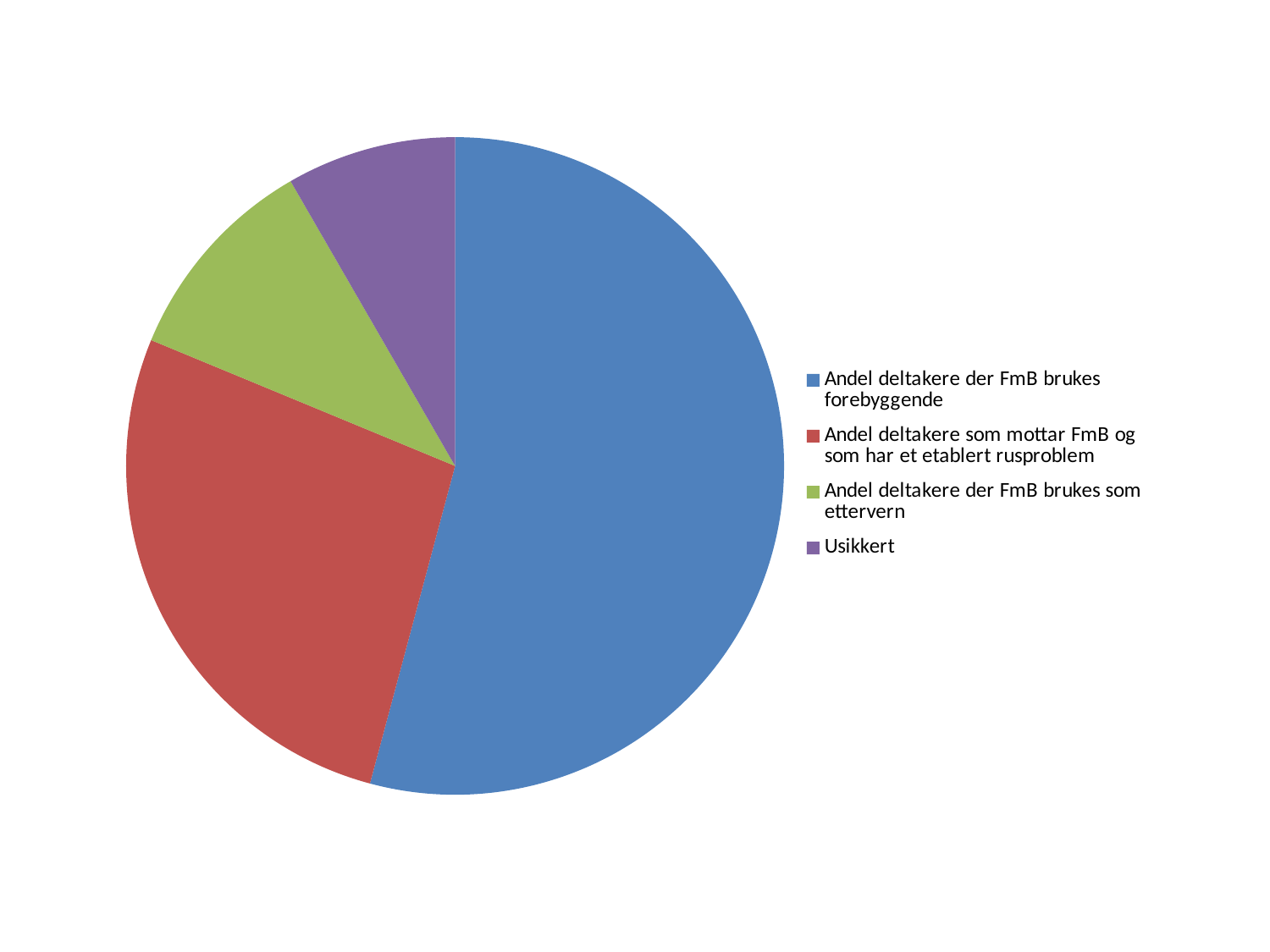
Which category has the largest slice of the pie? Andel deltakere der FmB brukes forebyggende Which slice is larger: "Andel deltakere der FmB brukes forebyggende" or "Usikkert"? Andel deltakere der FmB brukes forebyggende Which colour represents the "Usikkert" category in the pie chart? purple How many entries does the legend list? 4 How many slices does the pie chart have? 4 What kind of chart is shown on the slide? pie chart Which slice is larger: "Andel deltakere som mottar FmB og som har et etablert rusproblem" or "Andel deltakere der FmB brukes som ettervern"? Andel deltakere som mottar FmB og som har et etablert rusproblem Which category is shown in green in the pie chart? Andel deltakere der FmB brukes som ettervern Which slice is larger: "Andel deltakere der FmB brukes forebyggende" or "Andel deltakere som mottar FmB og som har et etablert rusproblem"? Andel deltakere der FmB brukes forebyggende